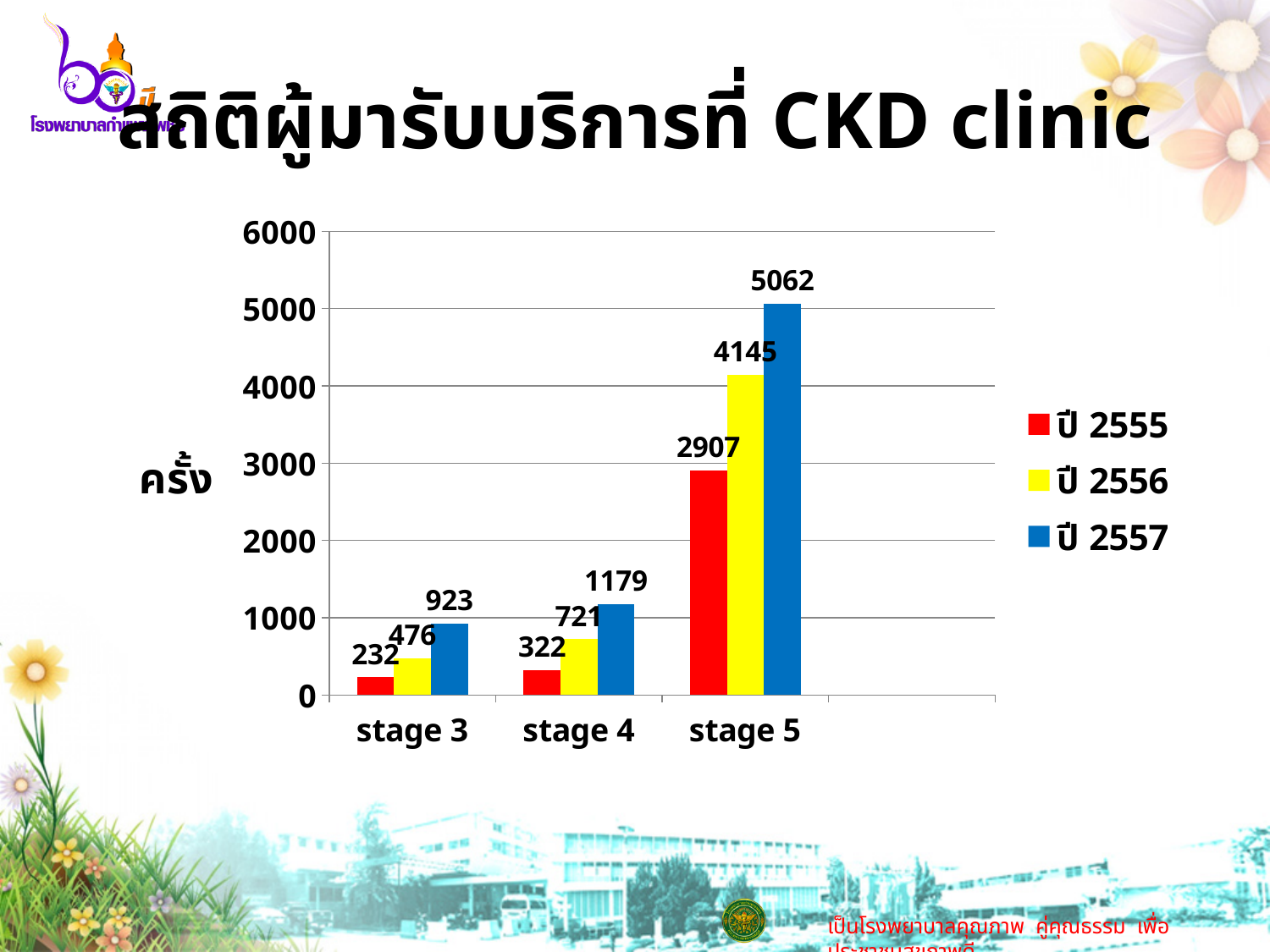
How many stage categories are shown on the x axis? 3 What is the difference between the ปี 2557 and ปี 2555 values for stage 4? 857 Which is larger for stage 3: the ปี 2556 value or the ปี 2557 value? ปี 2557 Which stage has the lowest value in the ปี 2555 series? stage 3 Is the value for stage 5 in the ปี 2555 series greater or less than 3000? less What is the value for stage 4 in the ปี 2556 series? 721 What is the value for stage 5 in the ปี 2557 series? 5062 Which stage has the highest value in the ปี 2557 series? stage 5 What kind of chart is shown on the slide? bar chart How many series does the legend list? 3 What is the value for stage 3 in the ปี 2555 series? 232 What is the difference between the ปี 2557 and ปี 2556 values for stage 5? 917